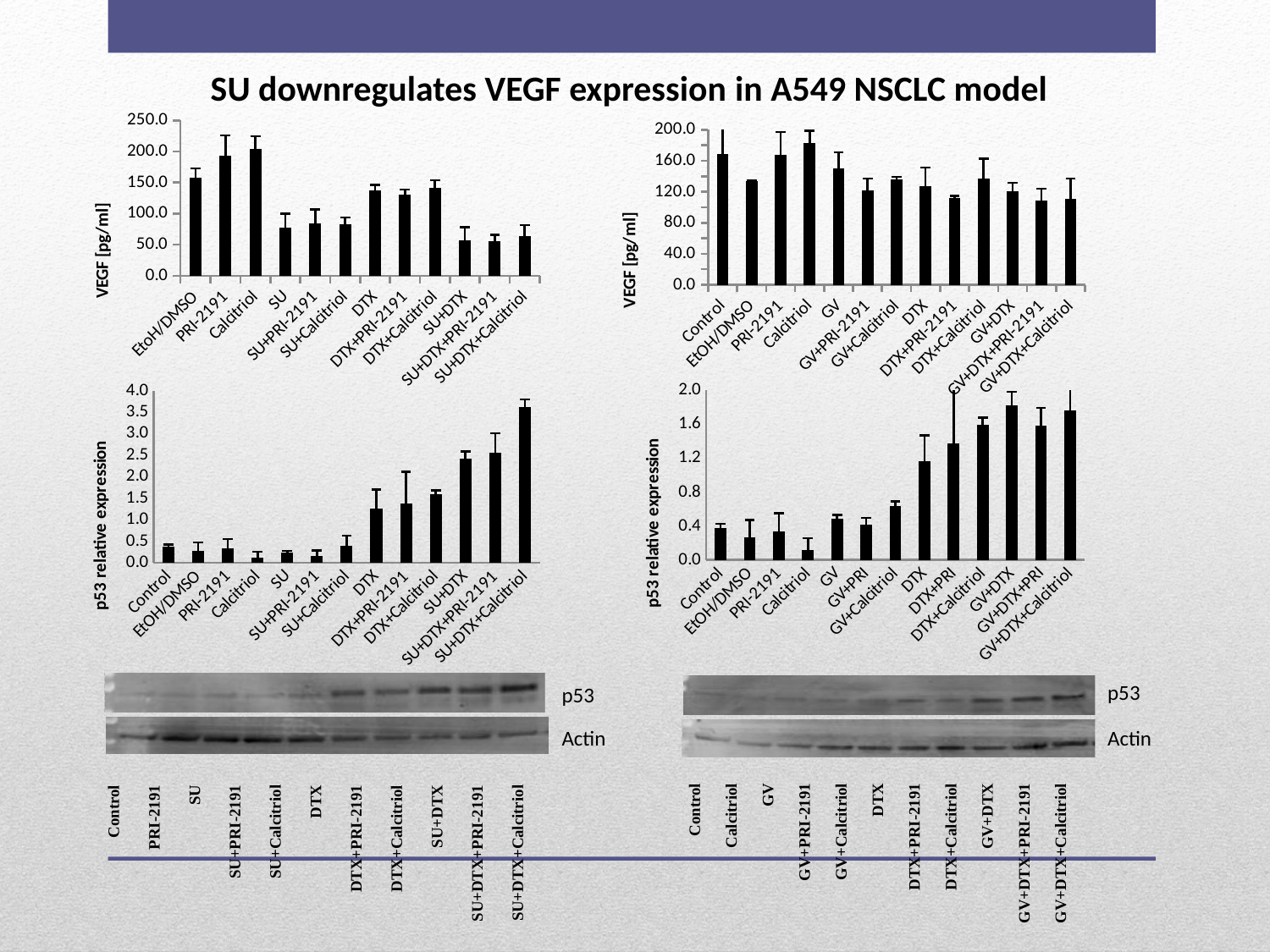
In the top-right VEGF [pg/ml] chart, which category has the highest value? Calcitriol In the top-right VEGF [pg/ml] chart, is the value for GV+PRI-2191 greater or less than 160.0? less In the top-right VEGF [pg/ml] chart, how many categories are plotted? 13 In the bottom-left p53 relative expression chart, is the value for DTX greater or less than 2.0? less In the bottom-right p53 relative expression chart, which category has the lowest value? Calcitriol What kind of chart is the top-left chart with the VEGF [pg/ml] axis? bar chart In the top-left VEGF [pg/ml] chart, is the value for SU greater or less than 100.0? less In the bottom-left p53 relative expression chart, which category has the highest value? SU+DTX+Calcitriol In the top-left VEGF [pg/ml] chart, which is larger, the value for Calcitriol or the value for SU? Calcitriol In the top-left VEGF [pg/ml] chart, how many categories are plotted? 12